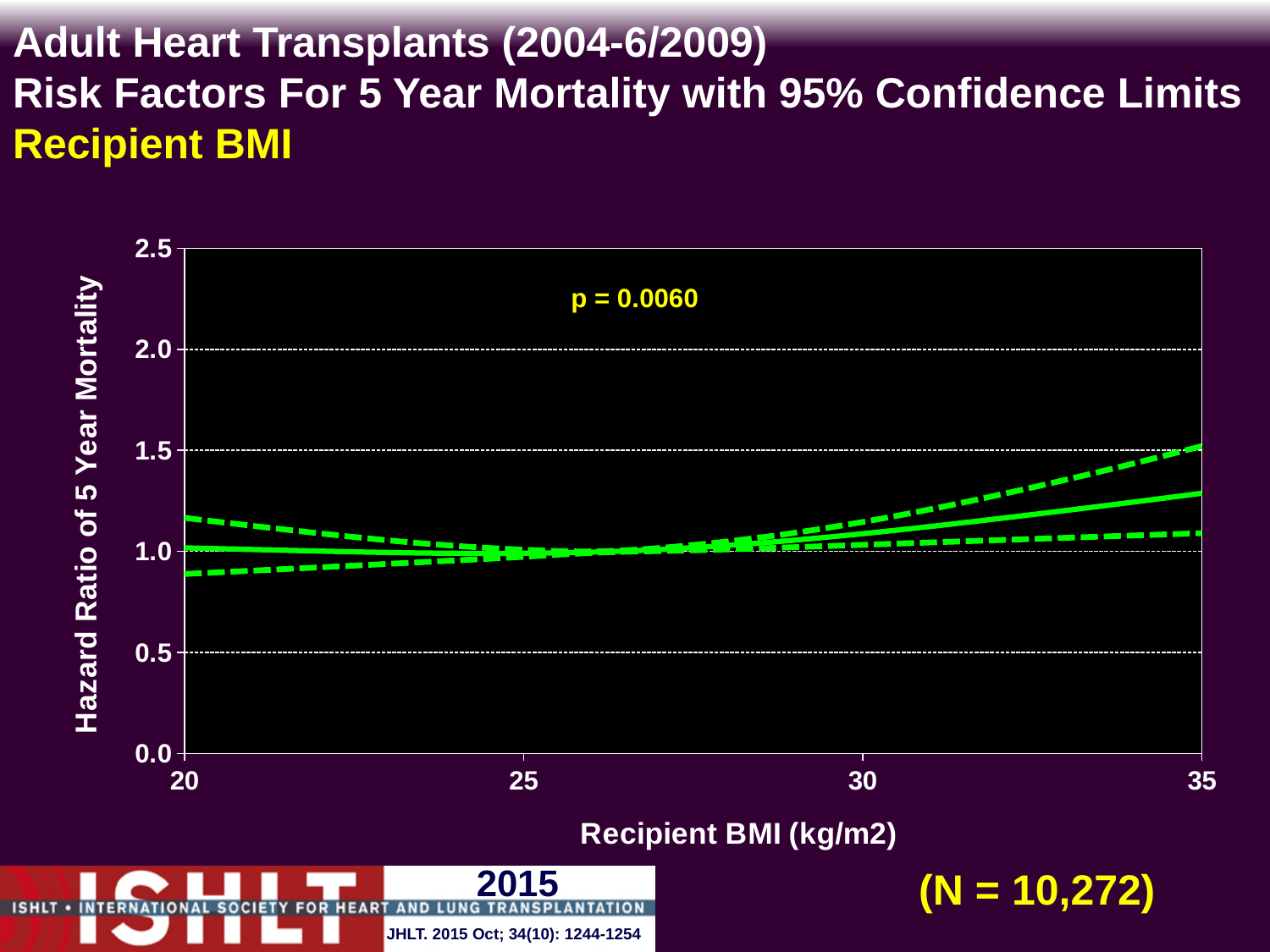
What p-value is printed on the chart? p = 0.0060 What is the highest tick value shown on the y axis? 2.5 Is the lower dashed confidence limit at a recipient BMI of 20 greater or less than 1.0? less Is the solid hazard ratio line at a recipient BMI of 35 greater or less than 1.0? greater Is the solid hazard ratio line at a recipient BMI of 35 greater or less than 1.5? less What kind of chart is shown on the slide? line chart Does the solid hazard ratio line rise or fall between a recipient BMI of 25 and 35? rise What is the label of the y axis? Hazard Ratio of 5 Year Mortality What sample size (N) is printed on the slide? N = 10,272 What is the label of the x axis? Recipient BMI (kg/m2) How many lines are plotted on the chart? 3